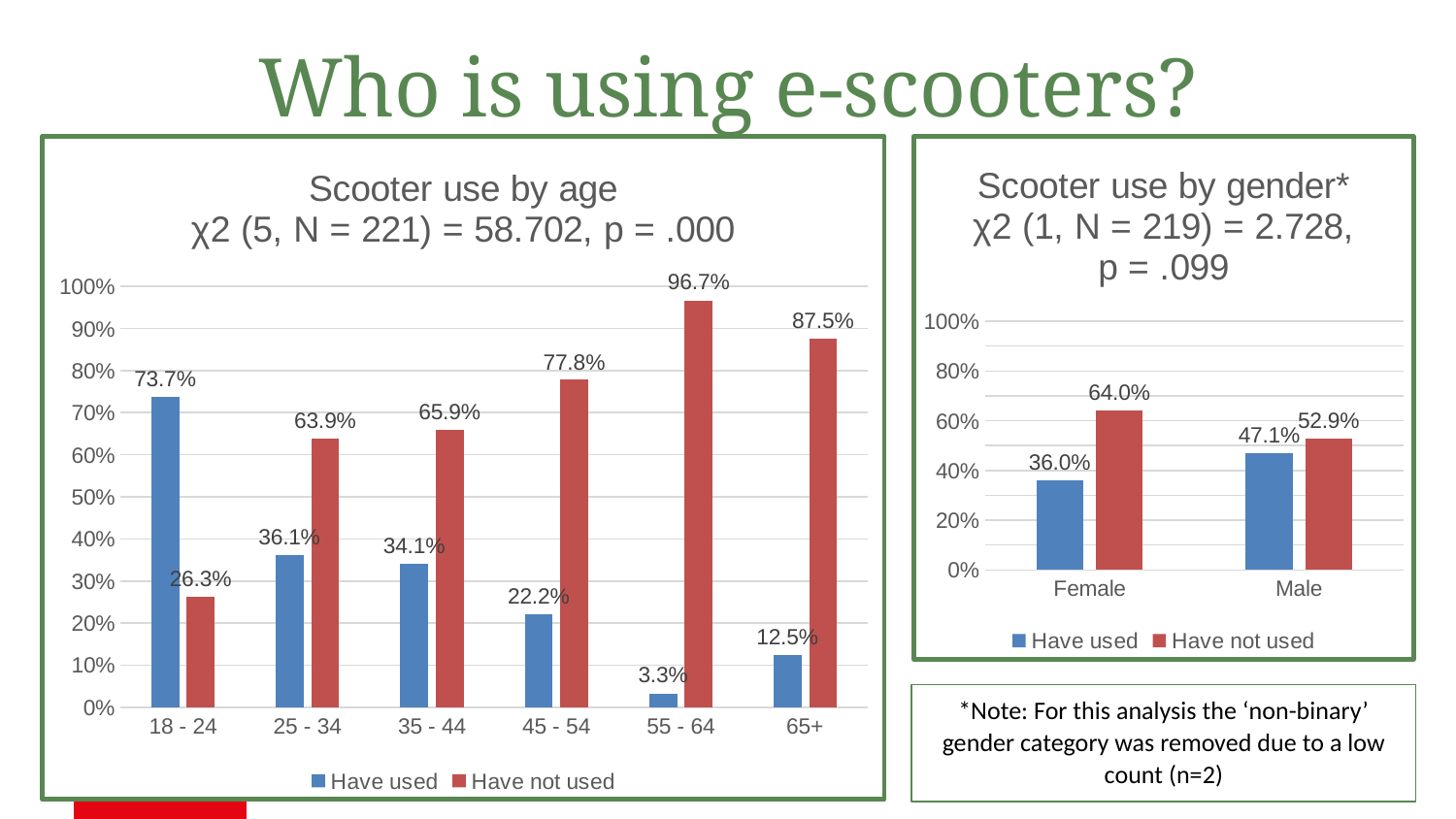
In the 'Scooter use by gender' chart, what is the difference between the 'Have not used' values for Female and Male? 11.1% In the 'Scooter use by age' chart, does the 'Have used' value generally rise or fall from the 18 - 24 group to the 55 - 64 group? fall In the 'Scooter use by age' chart, which age group has the highest 'Have used' value? 18 - 24 In the 'Scooter use by gender' chart, how many series does the legend list? 2 In the 'Scooter use by age' chart, what is the 'Have not used' value for the 55 - 64 age group? 96.7% In the 'Scooter use by age' chart, which age group has the lowest 'Have used' value? 55 - 64 In the 'Scooter use by age' chart, what is the 'Have used' value for the 18 - 24 age group? 73.7% In the 'Scooter use by age' chart, what is the difference between the 'Have not used' and 'Have used' values for the 45 - 54 age group? 55.6% In the 'Scooter use by age' chart, which is larger for the 25 - 34 age group: 'Have used' or 'Have not used'? Have not used In the 'Scooter use by gender' chart, what is the 'Have used' value for Female? 36.0% What type of chart is the 'Scooter use by gender' chart? bar chart In the 'Scooter use by age' chart, how many age groups are shown on the x axis? 6